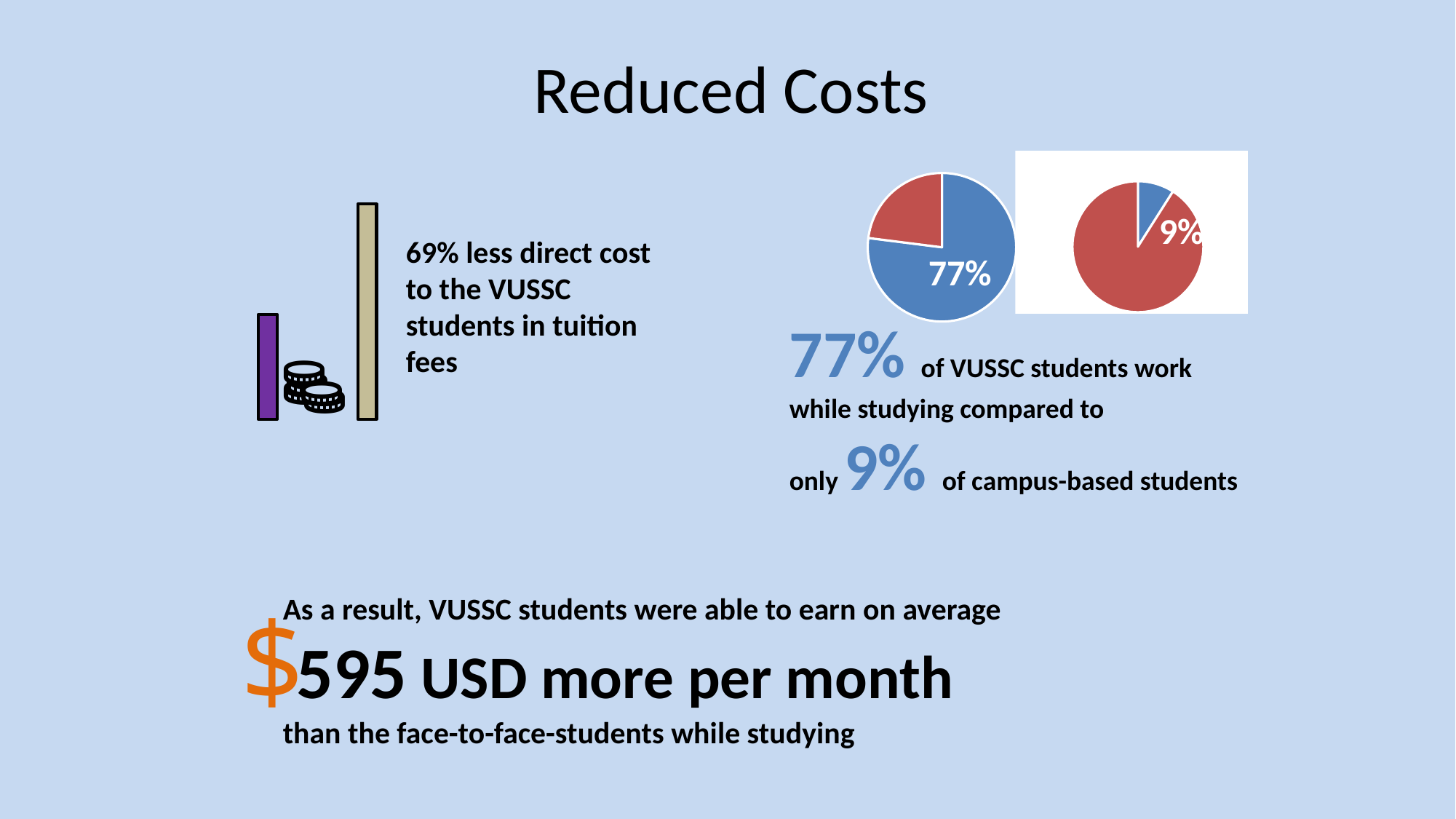
In the right pie chart, what value is printed on the blue slice? 9% What share of the right pie chart does the blue slice represent? 9% What colour is the larger slice in the right pie chart? red In the left pie chart, is the blue slice greater or less than 50% of the pie? greater How many slices does the right pie chart have? 2 What kind of chart is the left chart in the top-right area of the slide? pie chart Which pie chart has the larger blue slice, the left one or the right one? the left one In the left pie chart, what value is printed on the blue slice? 77% What share of the left pie chart does the blue slice represent? 77% How many slices does the left pie chart have? 2 What kind of chart is the right chart in the top-right area of the slide? pie chart What is the difference between the blue slice of the left pie chart (77%) and the blue slice of the right pie chart (9%)? 68%